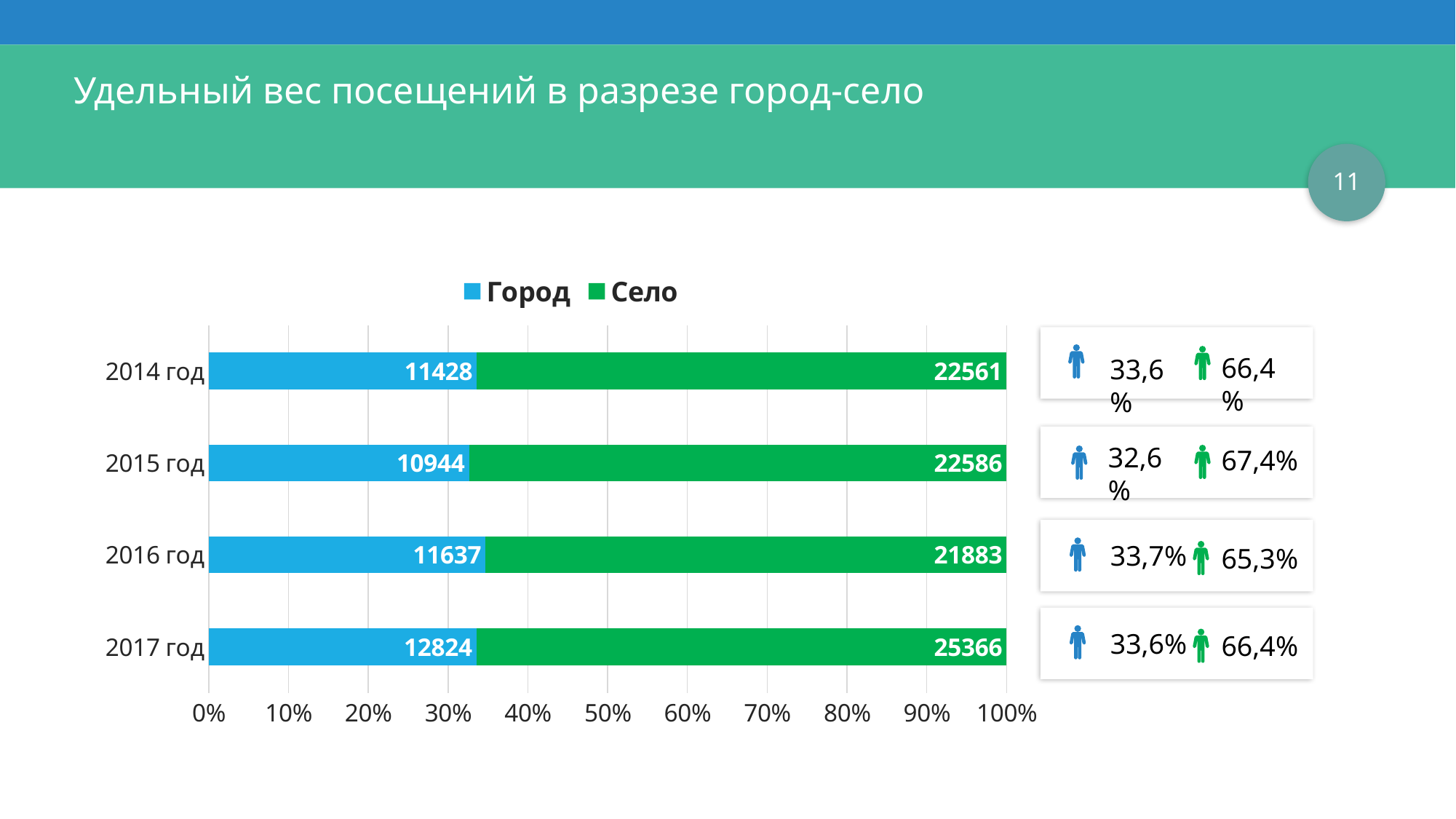
What is the total of the Город and Село values for 2015 год? 33530 How many years are shown on the chart? 4 What is the value for Город in 2017 год? 12824 Which year has the highest value for Село? 2017 год Is the Город share of the 2014 год bar greater or less than 40%? less What kind of chart is shown on the slide? stacked bar chart What is the difference between the Село and Город values in 2017 год? 12542 What is the value for Город in 2014 год? 11428 Which is larger: the Город value in 2016 год or the Город value in 2015 год? 2016 год How many series does the legend list? 2 What is the value for Село in 2016 год? 21883 Which year has the lowest value for Город? 2015 год